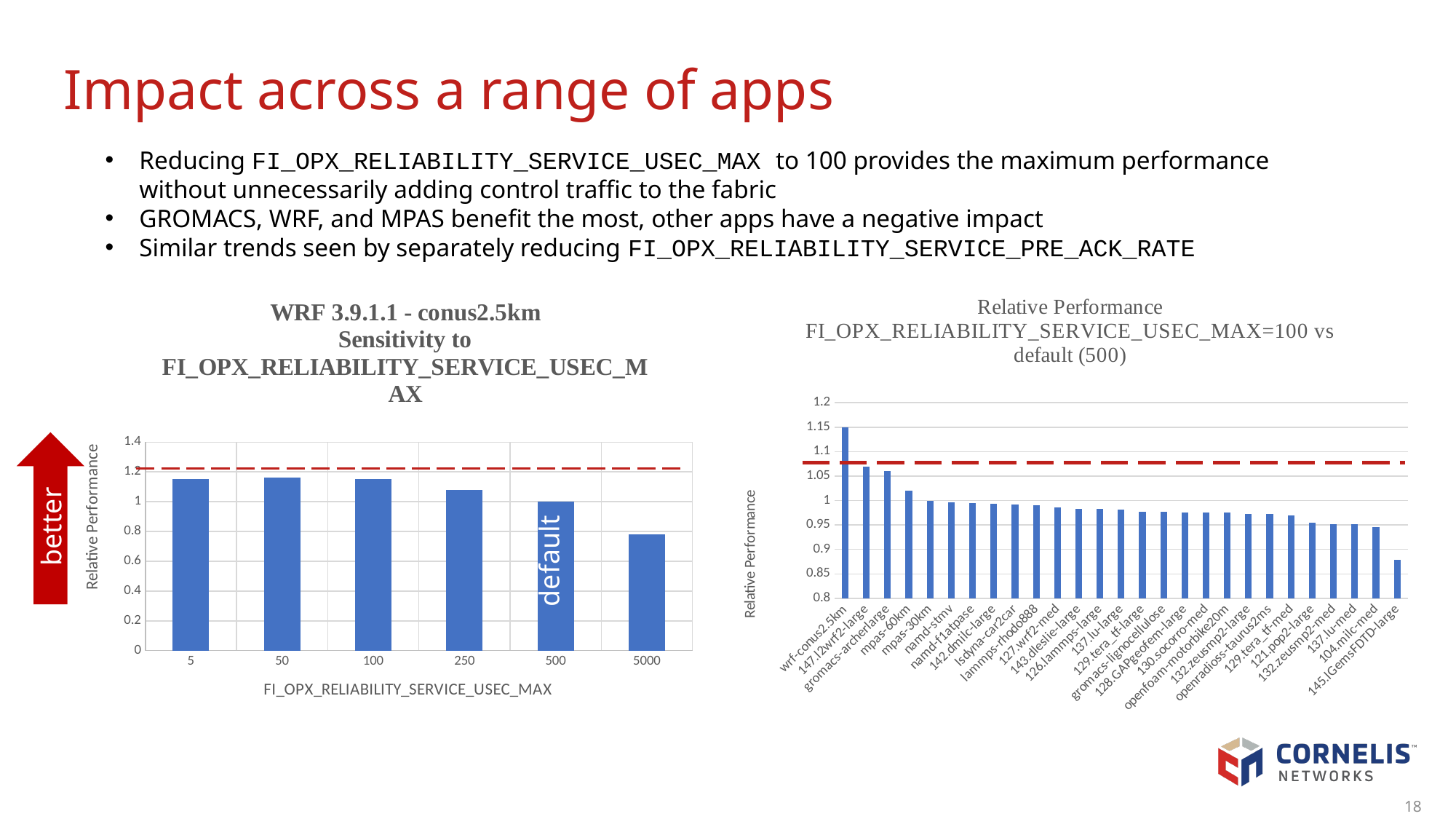
In the right chart (Relative Performance FI_OPX_RELIABILITY_SERVICE_USEC_MAX=100 vs default (500)), which application has the lowest relative performance? 145.lGemsFDTD-large In the left chart (WRF 3.9.1.1 - conus2.5km), is the relative performance for the 250 setting greater or less than 1? greater What type of chart is the left chart titled 'WRF 3.9.1.1 - conus2.5km Sensitivity to FI_OPX_RELIABILITY_SERVICE_USEC_MAX'? Bar chart In the left chart (WRF 3.9.1.1 - conus2.5km), which FI_OPX_RELIABILITY_SERVICE_USEC_MAX setting has the lowest relative performance? 5000 In the left chart (WRF 3.9.1.1 - conus2.5km), which has higher relative performance: the 100 setting or the 500 setting? 100 In the right chart (Relative Performance FI_OPX_RELIABILITY_SERVICE_USEC_MAX=100 vs default (500)), do the bar values rise or fall from left to right along the x axis? fall In the left chart (WRF 3.9.1.1 - conus2.5km), what is the label on the x axis? FI_OPX_RELIABILITY_SERVICE_USEC_MAX In the right chart (Relative Performance FI_OPX_RELIABILITY_SERVICE_USEC_MAX=100 vs default (500)), is the value for 145.lGemsFDTD-large greater or less than 0.9? less In the left chart (WRF 3.9.1.1 - conus2.5km), how many FI_OPX_RELIABILITY_SERVICE_USEC_MAX settings are plotted? 6 In the right chart (Relative Performance FI_OPX_RELIABILITY_SERVICE_USEC_MAX=100 vs default (500)), which application has the highest relative performance? wrf-conus2.5km In the right chart (Relative Performance FI_OPX_RELIABILITY_SERVICE_USEC_MAX=100 vs default (500)), is the value for wrf-conus2.5km greater or less than 1.1? greater